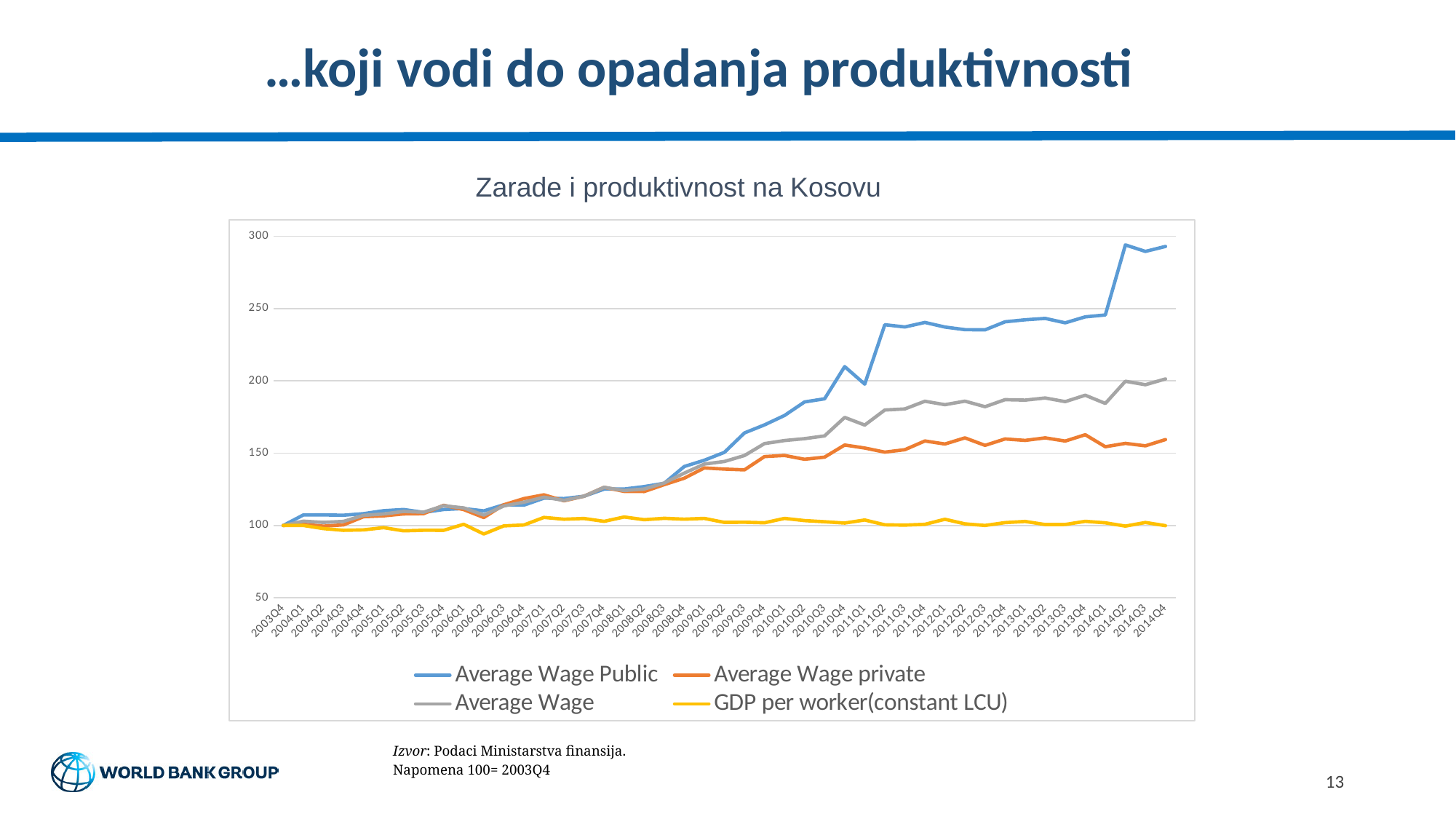
Which series is plotted in yellow? GDP per worker(constant LCU) Is the value for Average Wage private at 2014Q4 greater or less than 150? greater At 2014Q4, which is larger: Average Wage Public or Average Wage private? Average Wage Public Is the value for GDP per worker(constant LCU) at 2014Q4 greater or less than 150? less What is the title of the chart? Zarade i produktivnost na Kosovu How many quarters are shown on the x axis, from 2003Q4 to 2014Q4? 45 Which series reaches the highest value on the chart? Average Wage Public How many series does the legend list? 4 Is the value for Average Wage Public at 2014Q4 greater or less than 250? greater What kind of chart is shown on the slide? line chart Which series has the lowest value at 2014Q4? GDP per worker(constant LCU) Does the Average Wage Public series rise or fall from 2003Q4 to 2014Q4? rise